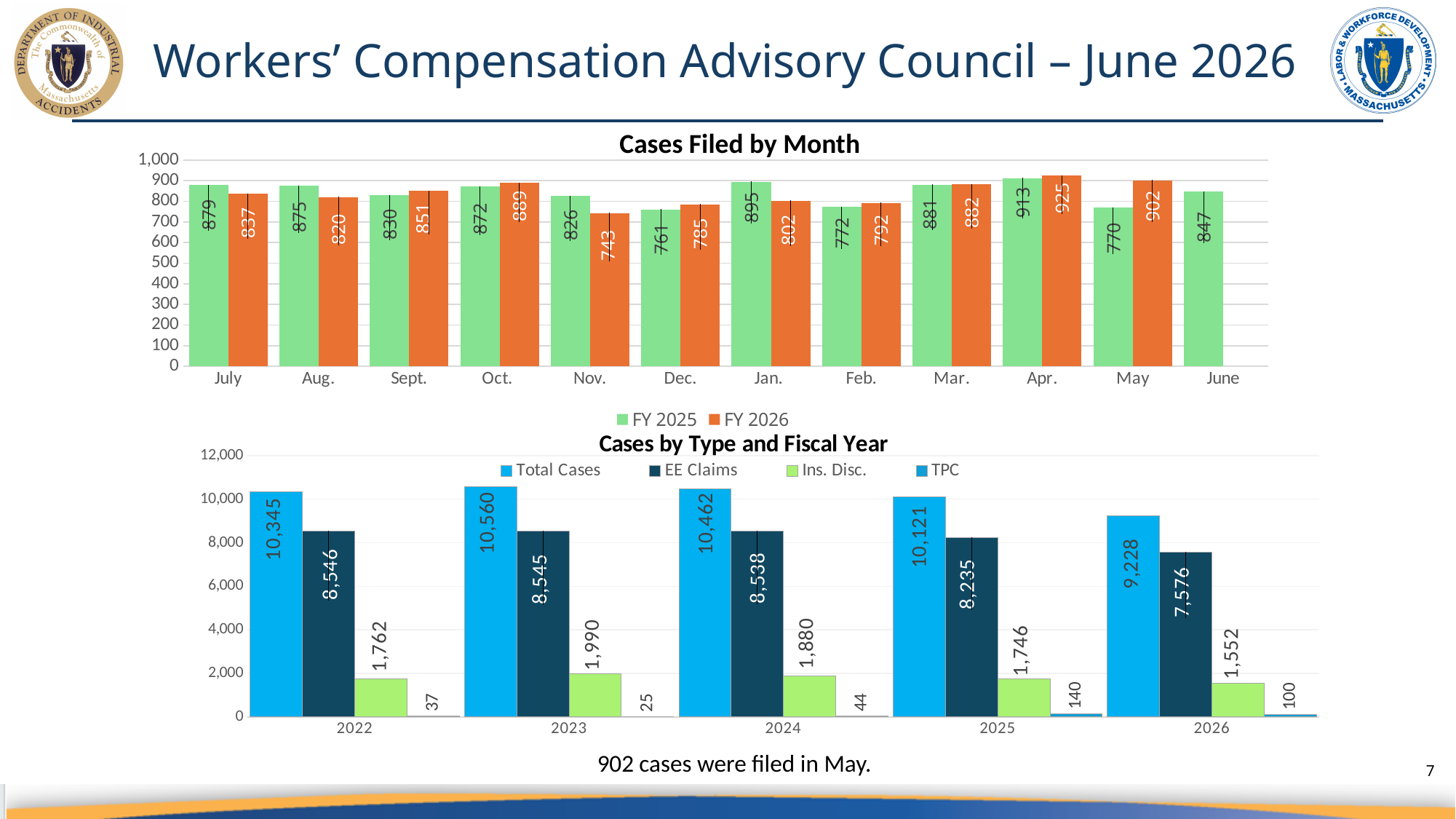
In the 'Cases by Type and Fiscal Year' chart, what is the difference between the Ins. Disc. values for 2023 and 2026? 438 In the 'Cases by Type and Fiscal Year' chart, which year has the lowest EE Claims value? 2026 In the 'Cases Filed by Month' chart, which is larger for September: FY 2025 or FY 2026? FY 2026 How many series does the legend of the 'Cases Filed by Month' chart list? 2 In the 'Cases Filed by Month' chart, which month has the highest FY 2026 value? Apr. What kind of chart is 'Cases by Type and Fiscal Year'? Bar chart In the 'Cases by Type and Fiscal Year' chart, what is the Total Cases value for 2023? 10,560 In the 'Cases Filed by Month' chart, what is the difference between the FY 2025 and FY 2026 values for November? 83 In the 'Cases Filed by Month' chart, which month has the lowest FY 2026 value? Nov. In the 'Cases Filed by Month' chart, what is the FY 2025 value for January? 895 In the 'Cases by Type and Fiscal Year' chart, what is the TPC value for 2025? 140 In the 'Cases Filed by Month' chart, how many cases were filed in May for FY 2026? 902